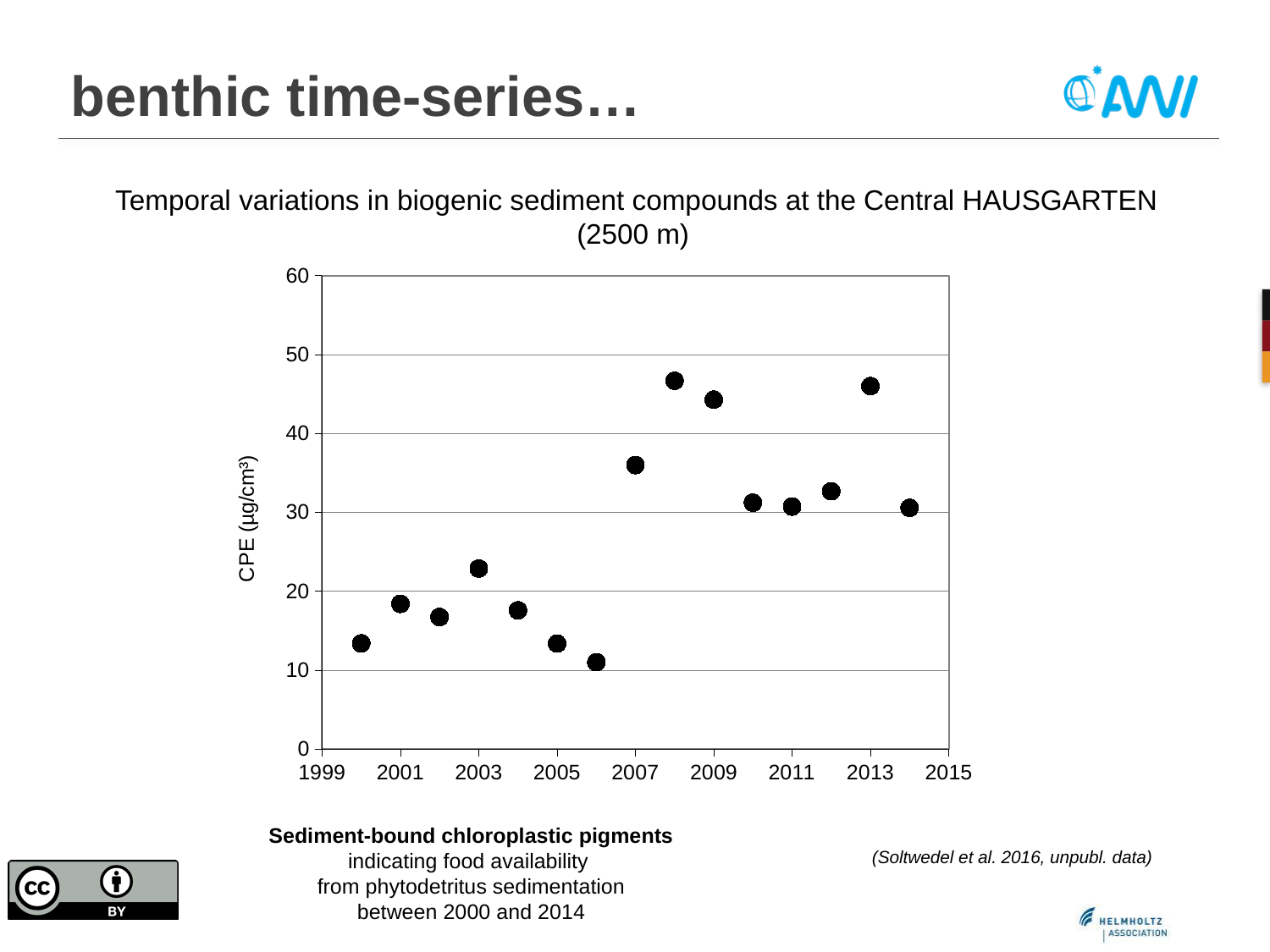
What is the label of the y axis? CPE (µg/cm³) Are the CPE values from 2007 onward generally higher or lower than those from 2000 to 2006? higher Is the CPE value for 2006 greater or less than 20? less How many data points are plotted in the chart? 15 Is the CPE value for 2000 greater or less than 20? less Which year has the larger CPE value, 2007 or 2013? 2013 Which year has the lowest CPE value? 2006 Which year has the larger CPE value, 2008 or 2000? 2008 Is the CPE value for 2003 greater or less than 20? greater What kind of chart is shown on the slide? scatter chart